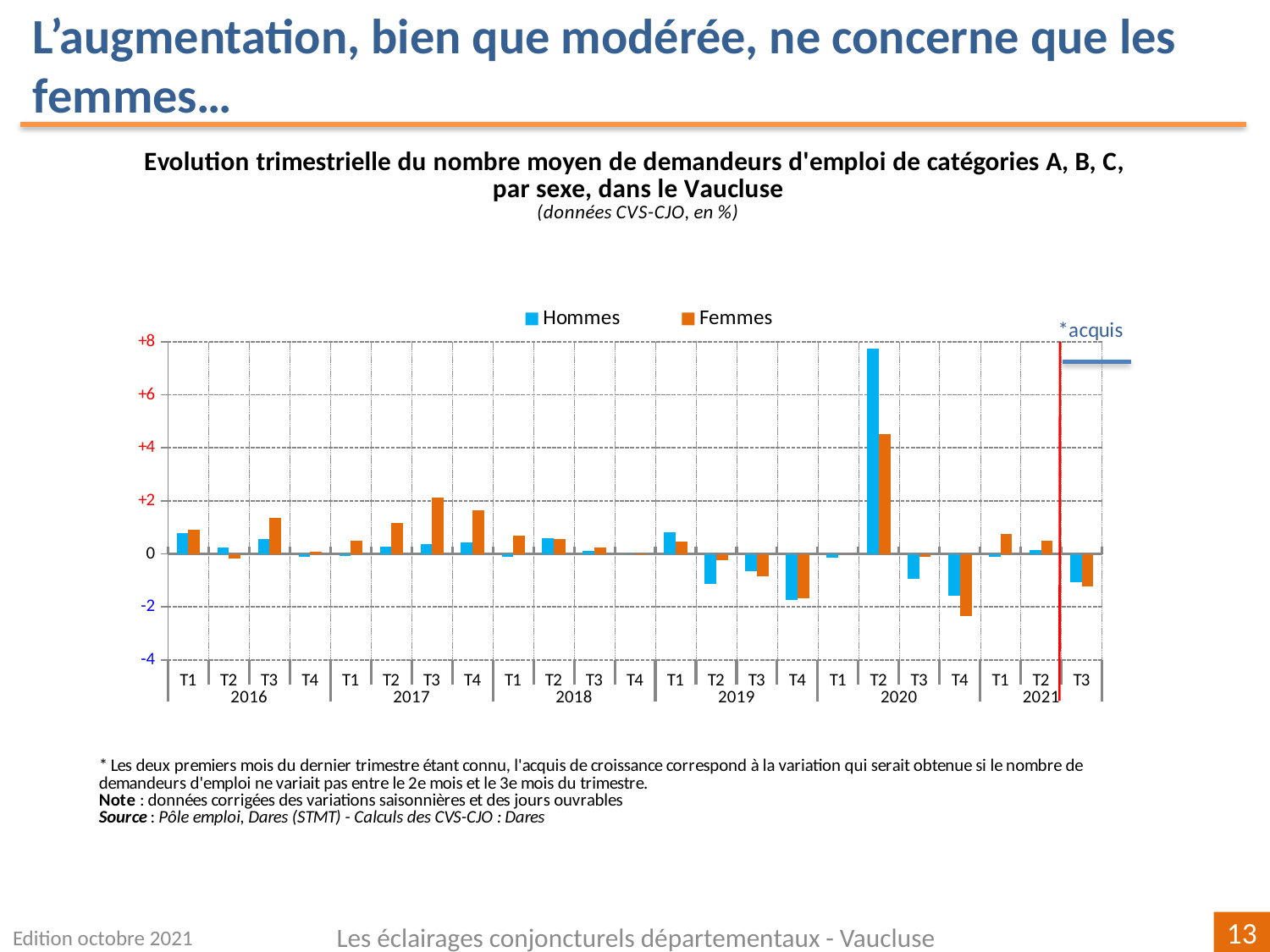
Is the value for Hommes in T2 2020 greater or less than +6? greater In which quarter is the value for Femmes highest? T2 2020 In T3 2017, which series has the larger value, Hommes or Femmes? Femmes Is the value for Femmes in T4 2020 greater or less than -2? less Which series is shown in blue? Hommes Is the value for Femmes in T3 2017 greater or less than +1? greater In which quarter is the value for Hommes highest? T2 2020 How many series does the legend list? 2 What kind of chart is shown on the slide? bar chart In which quarter is the value for Femmes lowest? T4 2020 In T2 2020, which series has the larger value, Hommes or Femmes? Hommes How many quarters are plotted on the x axis? 23